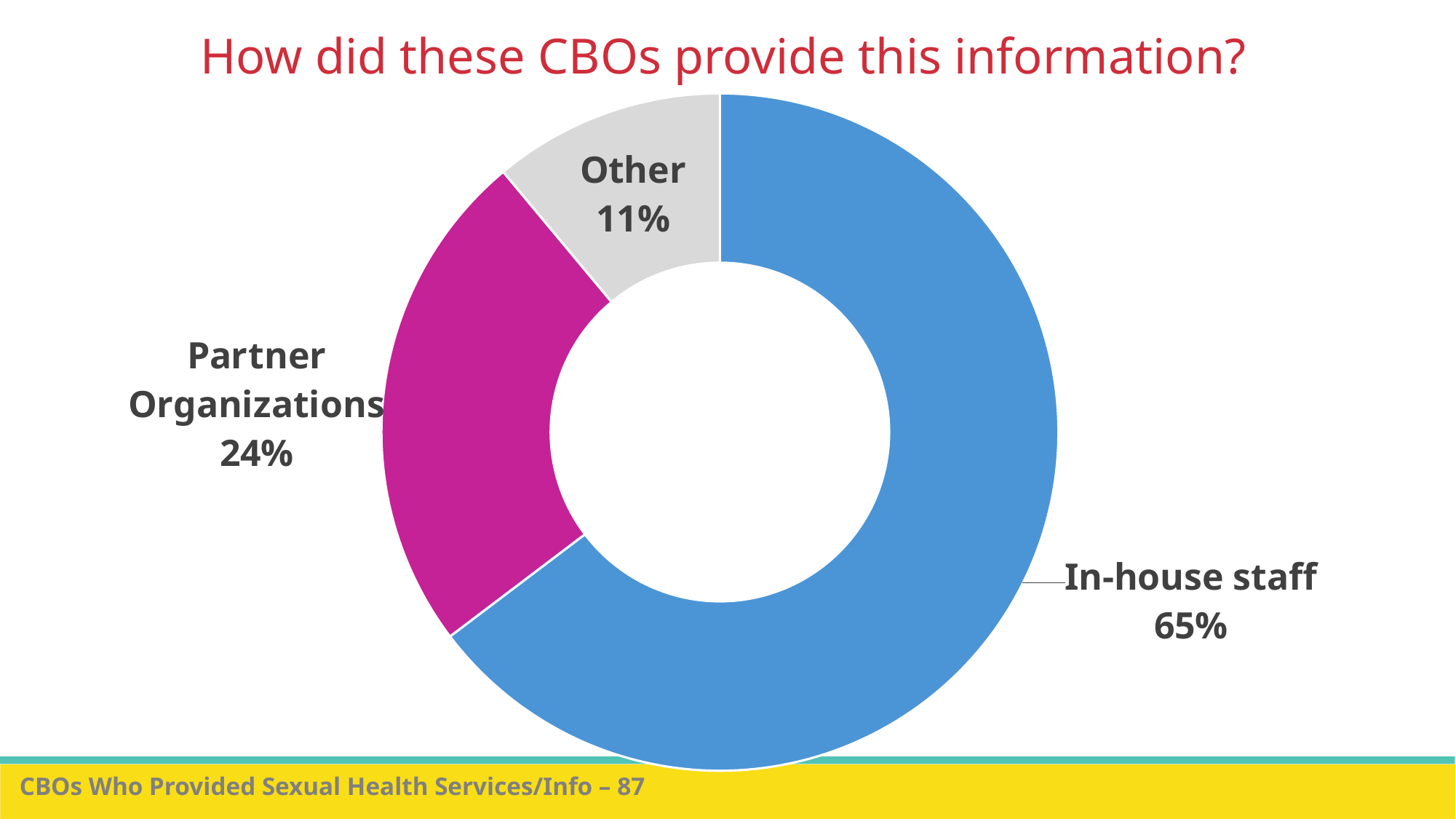
What kind of chart is shown on the slide? Doughnut chart What is the difference in percentage points between Partner Organizations and Other? 13 What share of CBOs provided this information through partner organizations? 24% Which category has the largest share of the chart? In-house staff What share of CBOs provided this information through 'Other' means? 11% How many categories are shown in the chart? 3 Which category has the smallest share of the chart? Other What share of CBOs provided this information through in-house staff? 65% What is the difference in percentage points between In-house staff and Partner Organizations? 41 Which is larger, the share for Partner Organizations or the share for Other? Partner Organizations What is the title of the slide? How did these CBOs provide this information? What colour is the In-house staff segment? Blue